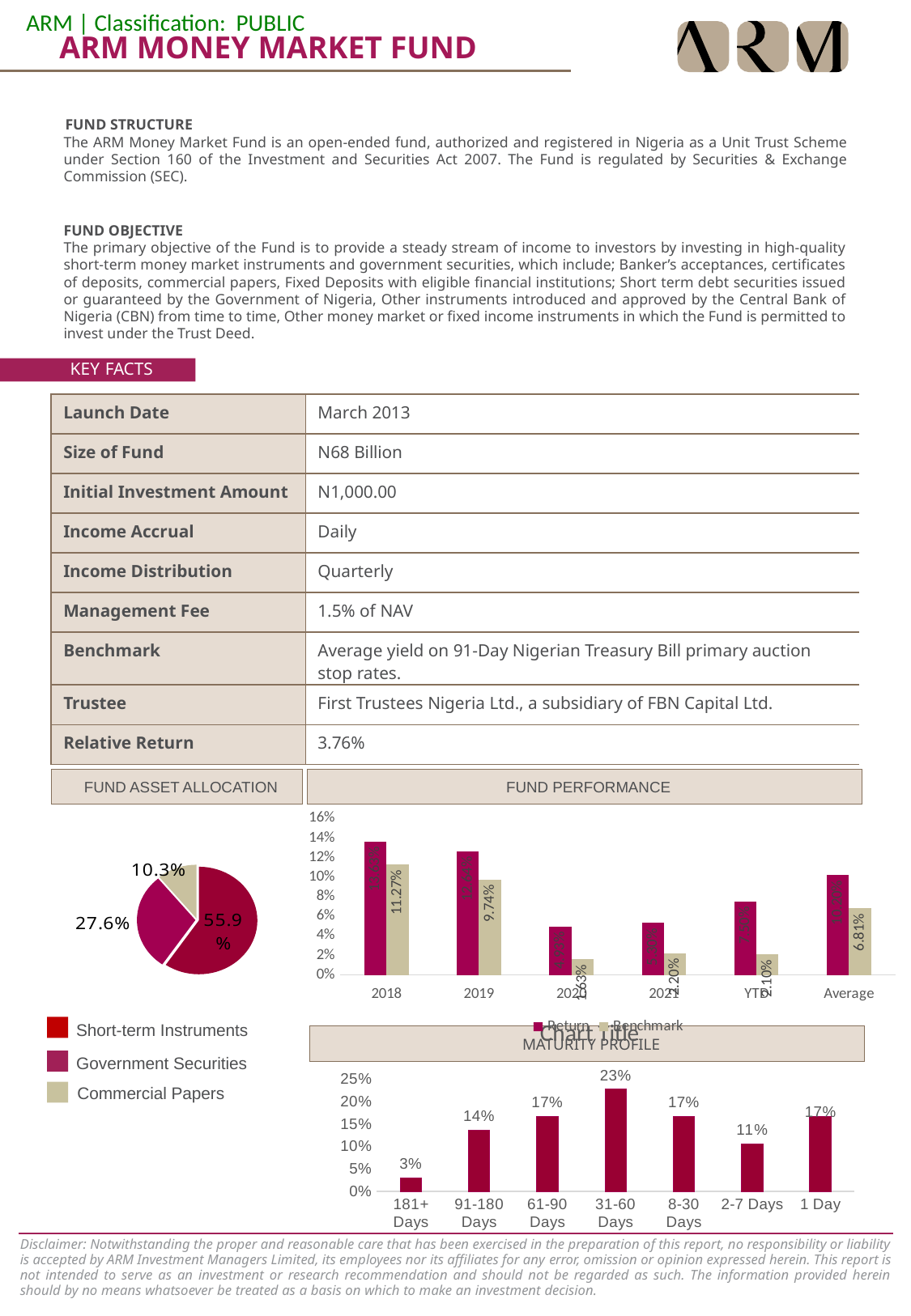
In the Maturity Profile chart, what is the value for 31-60 Days? 23% In the Maturity Profile chart, what is the difference between the values for 31-60 Days and 181+ Days? 20% In the Fund Performance chart, what is the Benchmark value for Average? 6.81% In the Fund Performance chart, what is the Benchmark value for 2019? 9.74% In the Fund Asset Allocation chart, what is the share of the largest slice? 55.9% In the Maturity Profile chart, how many maturity buckets are shown? 7 In the Maturity Profile chart, what is the value for 2-7 Days? 11% In the Fund Performance chart, is the Return value for 2018 greater or less than 12%? greater In the Fund Performance chart, what is the Benchmark value for 2018? 11.27% In the Maturity Profile chart, which maturity bucket has the highest value? 31-60 Days In the Maturity Profile chart, which maturity bucket has the lowest value? 181+ Days In the Fund Performance chart, how many series does the legend list? 2